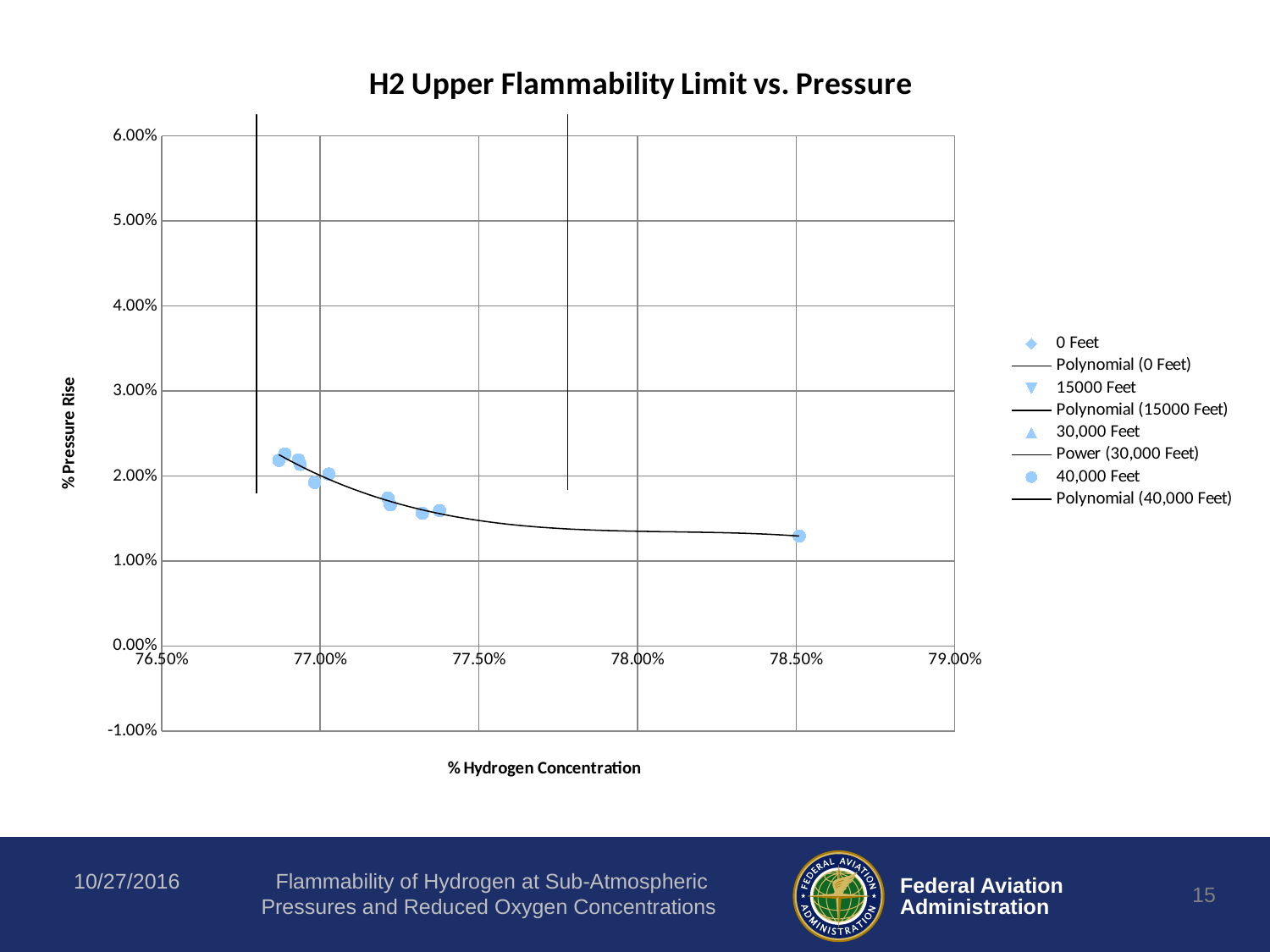
Are the pressure rise values for the leftmost data points (near 76.90% hydrogen concentration) greater or less than 3.00%? less Is the pressure rise value for the data point at 78.50% hydrogen concentration greater or less than 1.00%? greater What is the label of the chart's x axis? % Hydrogen Concentration What is the title of the chart? H2 Upper Flammability Limit vs. Pressure What is the highest value shown on the y axis? 6.00% What kind of chart is shown on the slide? Scatter chart How many entries does the chart legend list? 8 Which data point has the lowest pressure rise value, the one at 78.50% hydrogen concentration or the ones near 76.90%? The one at 78.50% As hydrogen concentration increases along the x axis, do the plotted pressure rise values rise or fall? Fall Is the pressure rise value for the data point at 78.50% hydrogen concentration greater or less than 2.00%? less